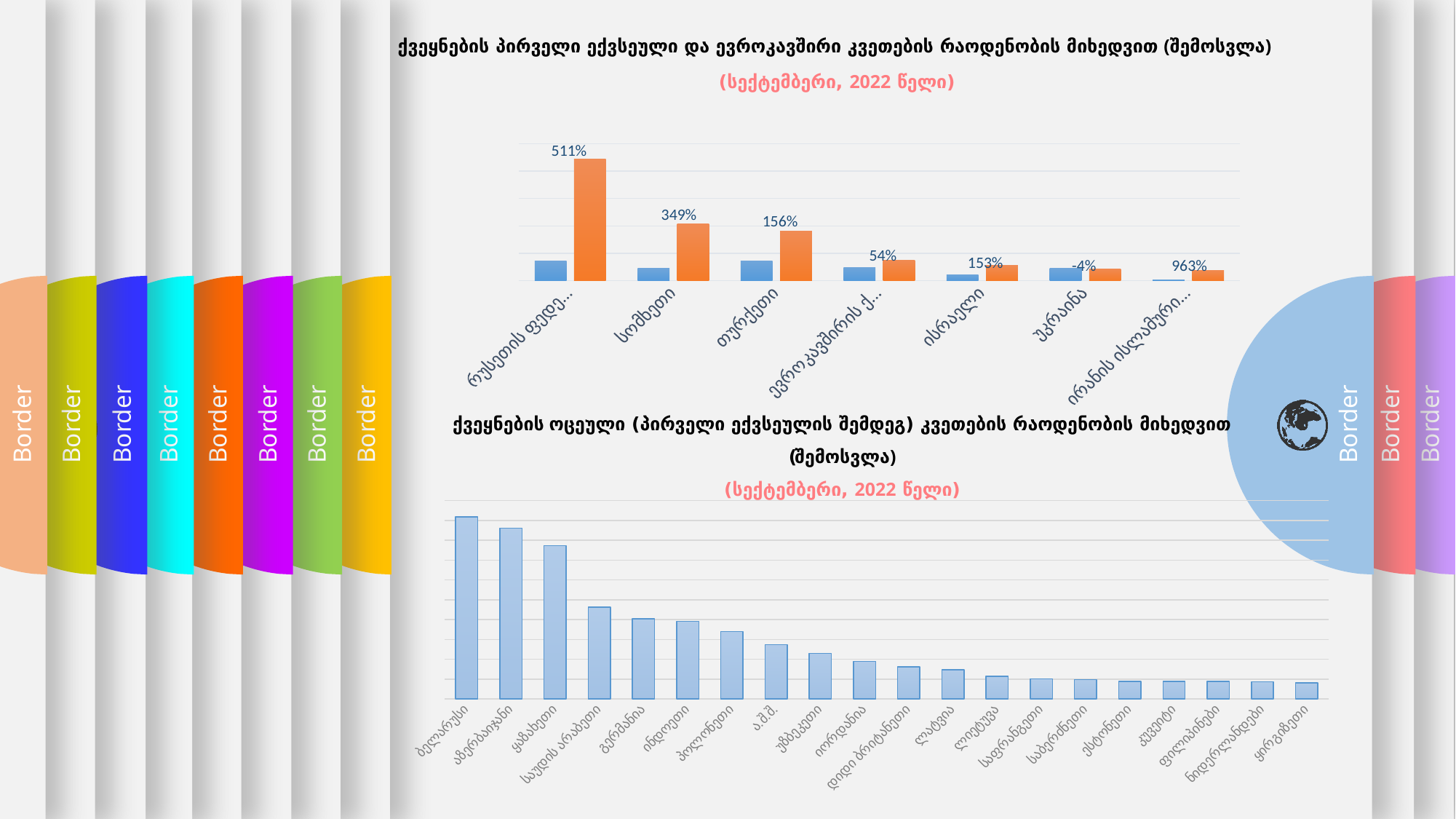
In the top chart, which category has the lowest labelled orange value? უკრაინა In the top chart, what is the data label on the orange bar for თურქეთი? 156% In the bottom chart, which has the taller bar, ყაზახეთი or საუდის არაბეთი? ყაზახეთი In the bottom chart, how many countries are shown on the x axis? 20 In the top chart, what is the data label on the orange bar for უკრაინა? -4% In the bottom chart, do the bar heights rise or fall from left to right? fall In the top chart, what is the data label on the orange bar for სომხეთი? 349% In the top chart, which has the larger labelled orange value, ისრაელი or ევროკავშირის ქ...? ისრაელი In the top chart, what is the difference between the labelled orange values for რუსეთის ფედე... and სომხეთი? 162% In the top chart, which category has the highest labelled orange value? ირანის ისლამური... In the bottom chart, which country has the tallest bar? ბელარუსი In the top chart, how many categories are shown on the x axis? 7